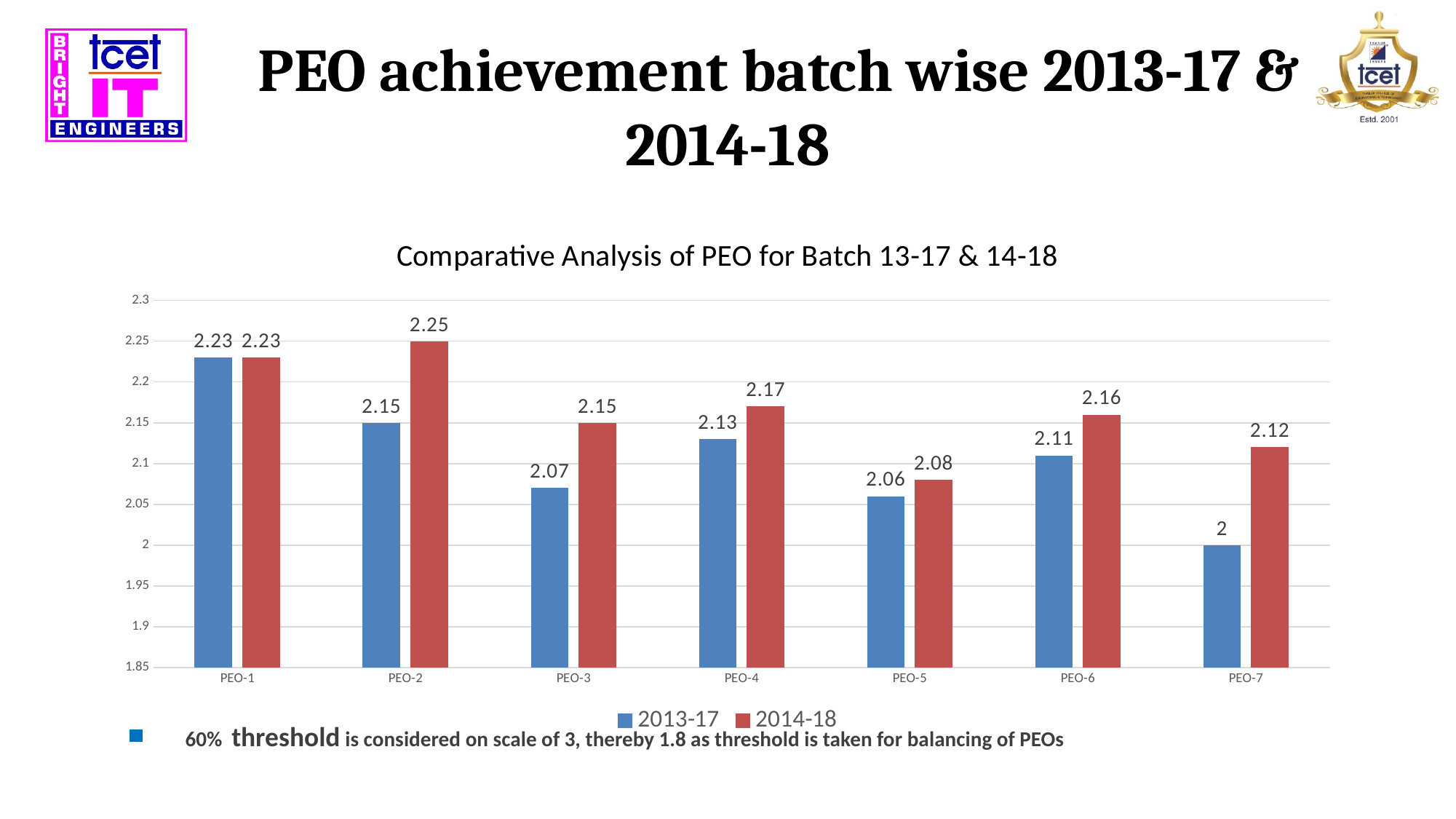
Is the value for PEO-5 in the 2013-17 series greater or less than 2.1? less What is the value for PEO-7 in the 2013-17 series? 2 How many series does the legend list? 2 What is the difference between the 2014-18 and 2013-17 values for PEO-2? 0.1 What type of chart is shown on the slide? Bar chart What is the difference between the 2014-18 and 2013-17 values for PEO-7? 0.12 Which PEO has the lowest value in the 2013-17 series? PEO-7 Which PEO has the highest value in the 2014-18 series? PEO-2 What is the value for PEO-3 in the 2013-17 series? 2.07 What is the value for PEO-6 in the 2014-18 series? 2.16 Which is larger for PEO-4: the 2013-17 value or the 2014-18 value? 2014-18 How many PEO categories are shown on the x axis? 7